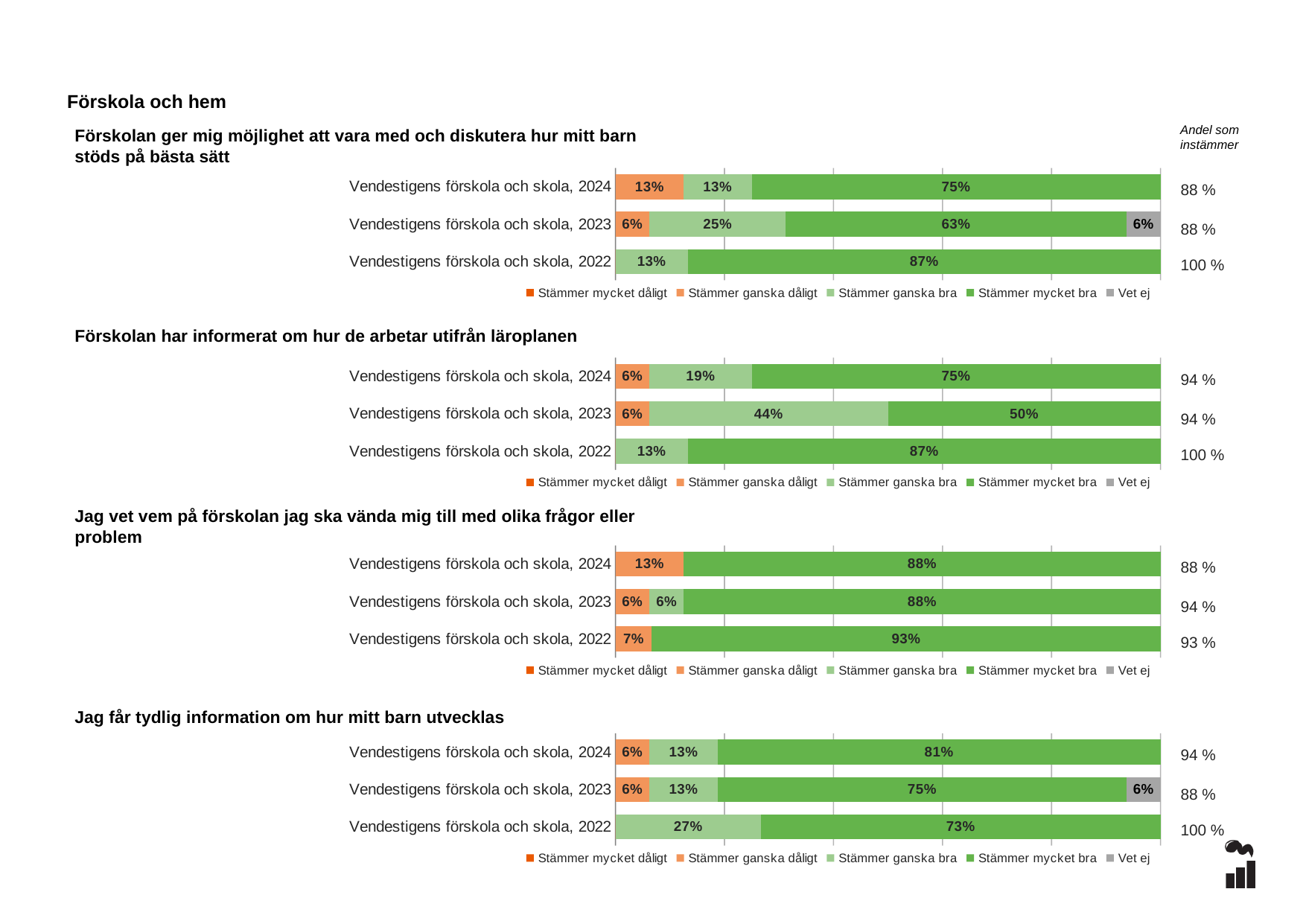
How many series does the legend list in the chart 'Förskolan ger mig möjlighet att vara med och diskutera hur mitt barn stöds på bästa sätt'? 5 In the chart 'Jag får tydlig information om hur mitt barn utvecklas', is the 'Stämmer mycket bra' value larger for 2022 or 2023? 2023 What kind of chart is 'Jag får tydlig information om hur mitt barn utvecklas'? Stacked bar chart In the chart 'Förskolan ger mig möjlighet att vara med och diskutera hur mitt barn stöds på bästa sätt', what is the 'Stämmer mycket bra' value for Vendestigens förskola och skola, 2023? 63% In the chart 'Jag får tydlig information om hur mitt barn utvecklas', what is the 'Vet ej' value for Vendestigens förskola och skola, 2023? 6% In the chart 'Förskolan har informerat om hur de arbetar utifrån läroplanen', what is the 'Stämmer ganska bra' value for Vendestigens förskola och skola, 2023? 44% In the chart 'Jag får tydlig information om hur mitt barn utvecklas', what is the 'Stämmer mycket bra' value for Vendestigens förskola och skola, 2024? 81% In the chart 'Förskolan har informerat om hur de arbetar utifrån läroplanen', which year has the highest 'Stämmer mycket bra' value? 2022 In the chart 'Jag vet vem på förskolan jag ska vända mig till med olika frågor eller problem', which year has the lowest 'Andel som instämmer'? 2024 In the chart 'Jag vet vem på förskolan jag ska vända mig till med olika frågor eller problem', what is the 'Stämmer ganska dåligt' value for Vendestigens förskola och skola, 2022? 7% In the chart 'Förskolan ger mig möjlighet att vara med och diskutera hur mitt barn stöds på bästa sätt', what is the 'Andel som instämmer' for Vendestigens förskola och skola, 2022? 100 % In the chart 'Förskolan har informerat om hur de arbetar utifrån läroplanen', what is the difference between the 'Stämmer mycket bra' values for 2024 and 2023? 25 percentage points